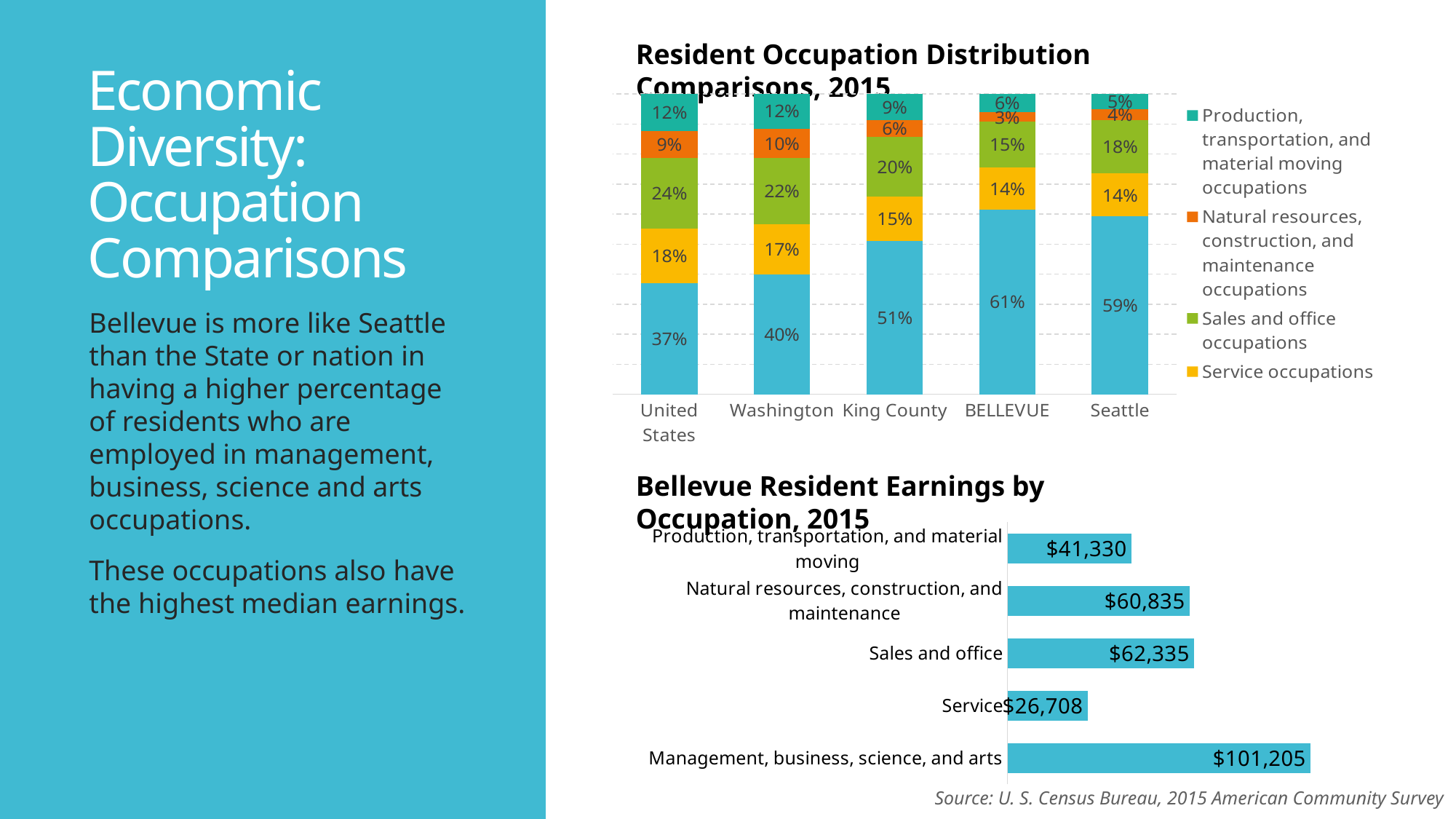
In the 'Resident Occupation Distribution Comparisons, 2015' chart, which has a larger share of Sales and office occupations, United States or Washington? United States In the 'Resident Occupation Distribution Comparisons, 2015' chart, what percentage is shown for Service occupations in King County? 15% How many occupation categories are shown in the 'Bellevue Resident Earnings by Occupation, 2015' chart? 5 In the 'Bellevue Resident Earnings by Occupation, 2015' chart, which occupation has the lowest earnings? Service How many geographic areas are compared in the 'Resident Occupation Distribution Comparisons, 2015' chart? 5 In the 'Resident Occupation Distribution Comparisons, 2015' chart, what percentage is shown for Sales and office occupations in Seattle? 18% What kind of chart is the 'Bellevue Resident Earnings by Occupation, 2015' chart? Bar chart In the 'Bellevue Resident Earnings by Occupation, 2015' chart, which occupation has the highest earnings? Management, business, science, and arts In the 'Bellevue Resident Earnings by Occupation, 2015' chart, what is the difference between the earnings for Sales and office and for Natural resources, construction, and maintenance? $1,500 In the 'Bellevue Resident Earnings by Occupation, 2015' chart, what are the earnings for Service occupations? $26,708 In the 'Resident Occupation Distribution Comparisons, 2015' chart, what is the value of the largest segment of the BELLEVUE bar? 61% In the 'Bellevue Resident Earnings by Occupation, 2015' chart, what are the earnings for Management, business, science, and arts? $101,205